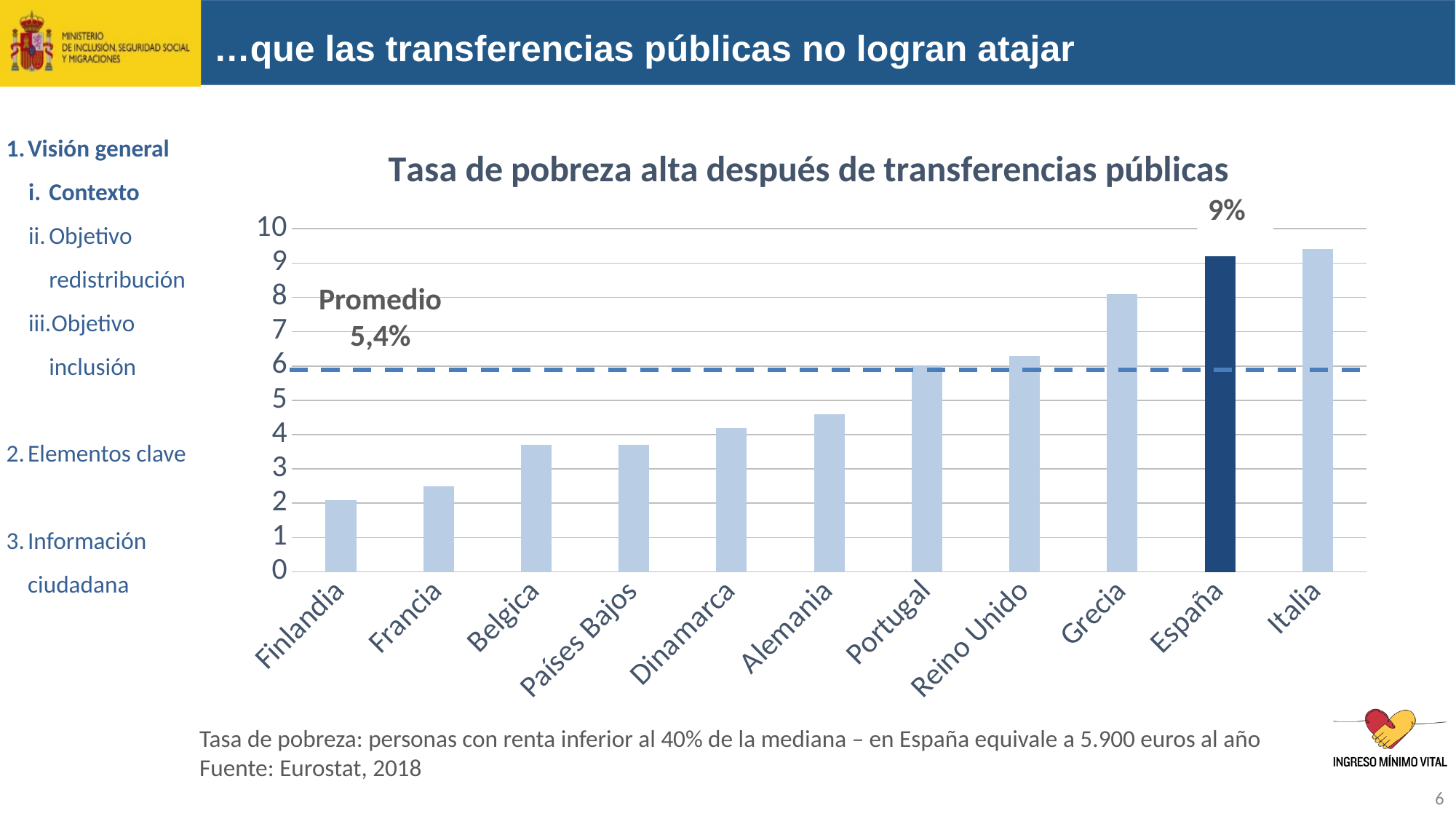
Which has the larger value, Francia or Belgica? Belgica Is the value for Alemania greater or less than 5? less Is the value for Finlandia greater or less than 3? less What is the value of the 'Promedio' (average) line shown on the chart? 5,4% What kind of chart is shown on the slide? Bar chart Is the value for Grecia greater or less than 7? greater What is the title of the chart? Tasa de pobreza alta después de transferencias públicas What is the value shown for España? 9% Which country has the lowest poverty rate in the chart? Finlandia Which has the larger value, Grecia or Alemania? Grecia How many countries are shown on the x axis? 11 Do the bar values rise or fall from left to right along the x axis? Rise